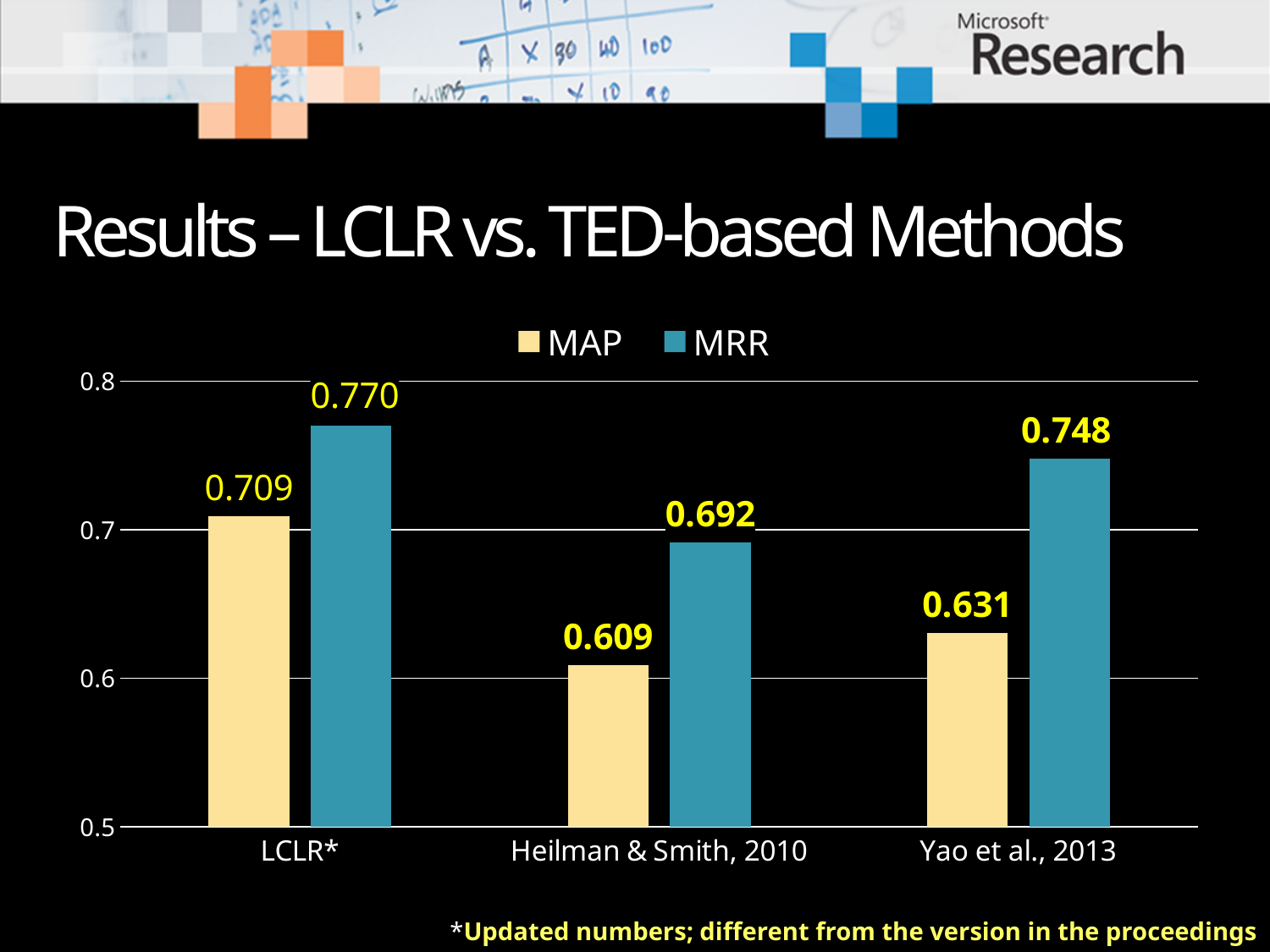
Is the MRR value for Yao et al., 2013 greater or less than 0.7? greater What is the difference between the MRR values of LCLR* and Yao et al., 2013? 0.022 Which is larger, the MAP value for Yao et al., 2013 or the MAP value for Heilman & Smith, 2010? Yao et al., 2013 What is the MAP value for LCLR*? 0.709 How many series does the legend list? 2 What is the difference between the MRR and MAP values for LCLR*? 0.061 What is the MAP value for Yao et al., 2013? 0.631 Which method has the highest MRR value? LCLR* Which method has the lowest MAP value? Heilman & Smith, 2010 What is the MRR value for Heilman & Smith, 2010? 0.692 How many methods are compared on the x axis? 3 What kind of chart is shown on the slide? bar chart